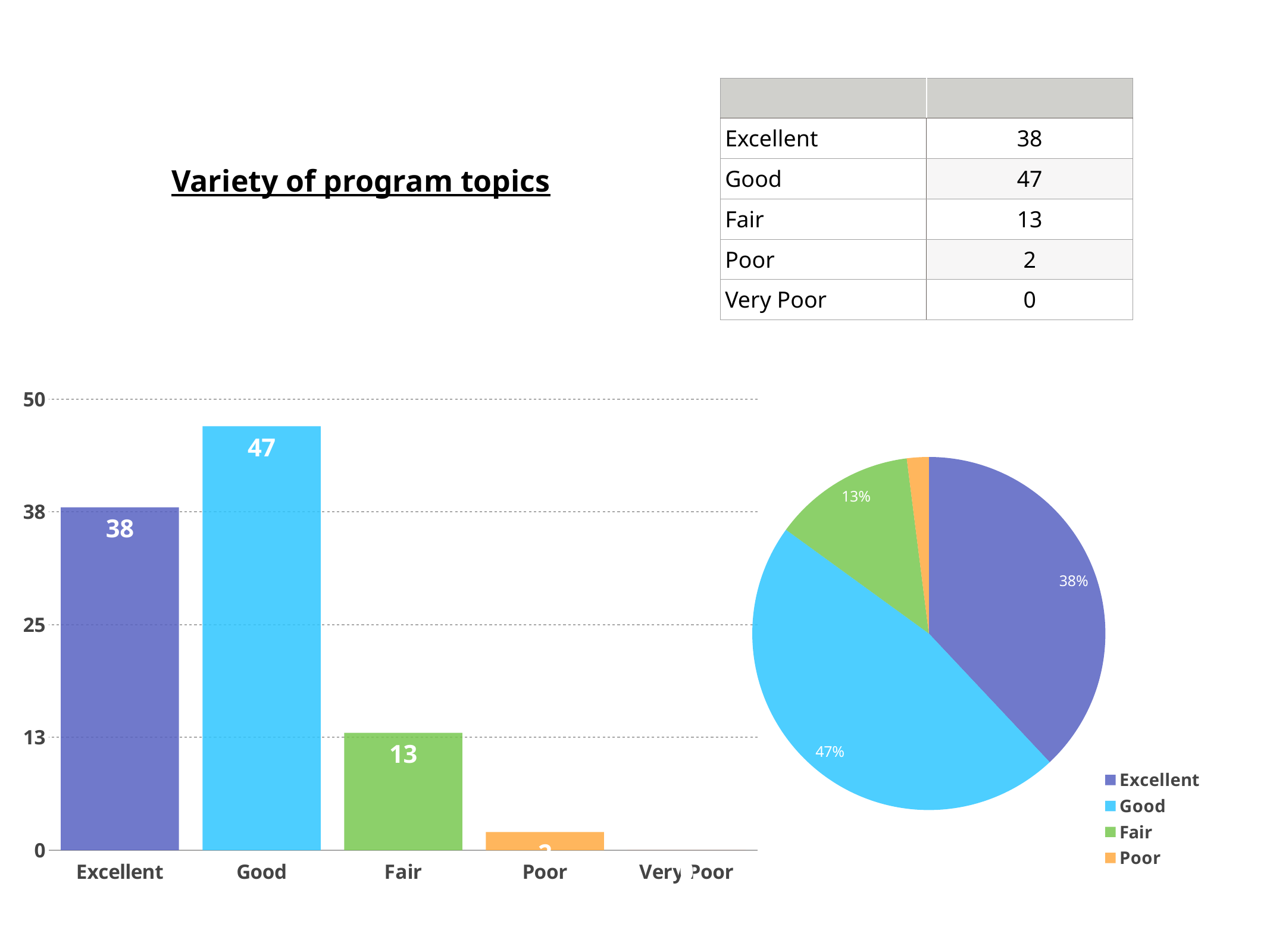
In the bar chart, what is the value for Good? 47 In the bar chart, what is the value for Excellent? 38 In the bar chart, which is larger, the value for Excellent or the value for Fair? Excellent In the bar chart, which category has the lowest value? Very Poor In the bar chart, what is the difference between the values for Good and Excellent? 9 In the bar chart, what is the value for Fair? 13 How many entries does the legend of the pie chart list? 4 In the bar chart, which category has the highest value? Good In the bar chart, is the value for Good greater or less than 38? greater In the pie chart, what share does the Good slice have? 47% How many categories are shown on the x axis of the bar chart? 5 What kind of chart is the chart on the left of the slide? bar chart